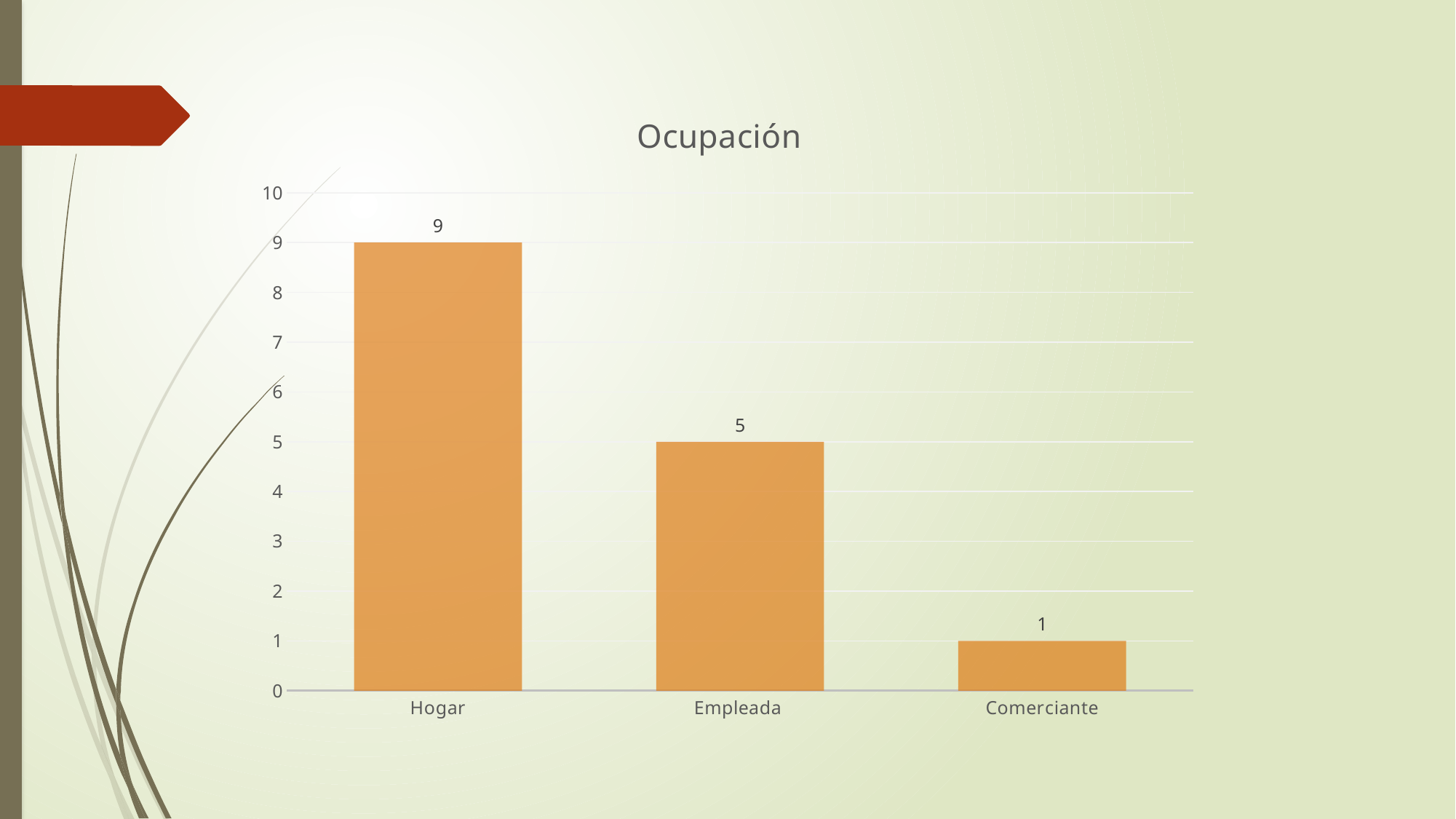
Which is larger, the value for Empleada or the value for Comerciante? Empleada What is the value for Empleada? 5 Which category has the lowest value? Comerciante What is the value for Hogar? 9 What is the difference between the values for Hogar and Empleada? 4 Which category has the highest value? Hogar What kind of chart is shown on the slide? Bar chart What is the title of the chart? Ocupación What is the value for Comerciante? 1 What is the difference between the values for Empleada and Comerciante? 4 Do the values rise or fall from left to right along the x axis? Fall How many categories are shown on the x axis? 3